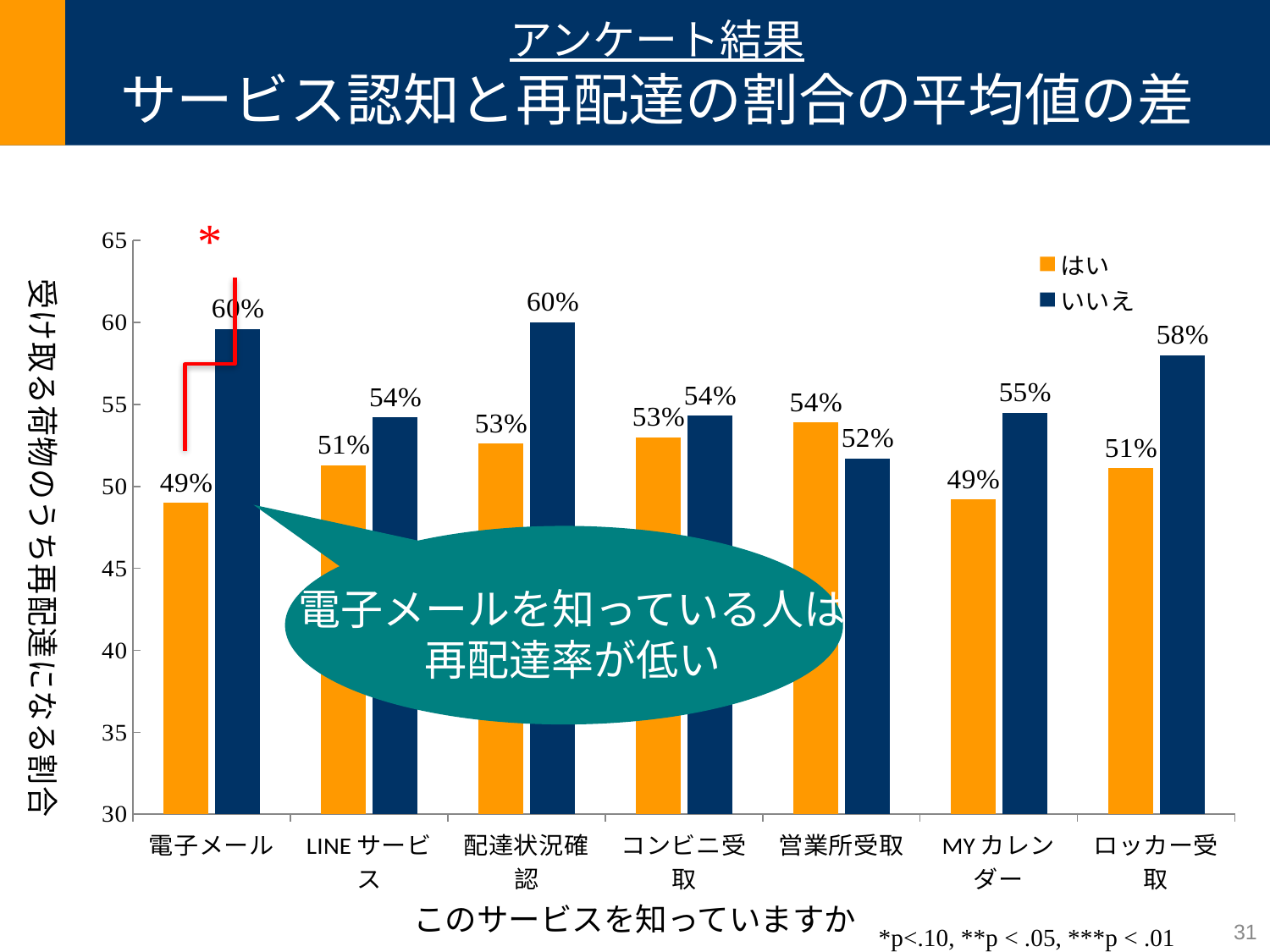
What is the value of the いいえ bar for MY カレンダー? 55% Which category has the highest はい value? 営業所受取 For 営業所受取, which is larger, the はい value or the いいえ value? はい What is the value of the いいえ bar for ロッカー受取? 58% What is the difference between the いいえ and はい values for 電子メール? 11 percentage points What kind of chart is shown on the slide? bar chart How many series does the legend list? 2 Which category has the lowest いいえ value? 営業所受取 Is the いいえ value for ロッカー受取 greater or less than 55? greater What is the value of the はい bar for 配達状況確認? 53% What is the value of the はい bar for 電子メール? 49% How many service categories are shown on the x axis? 7